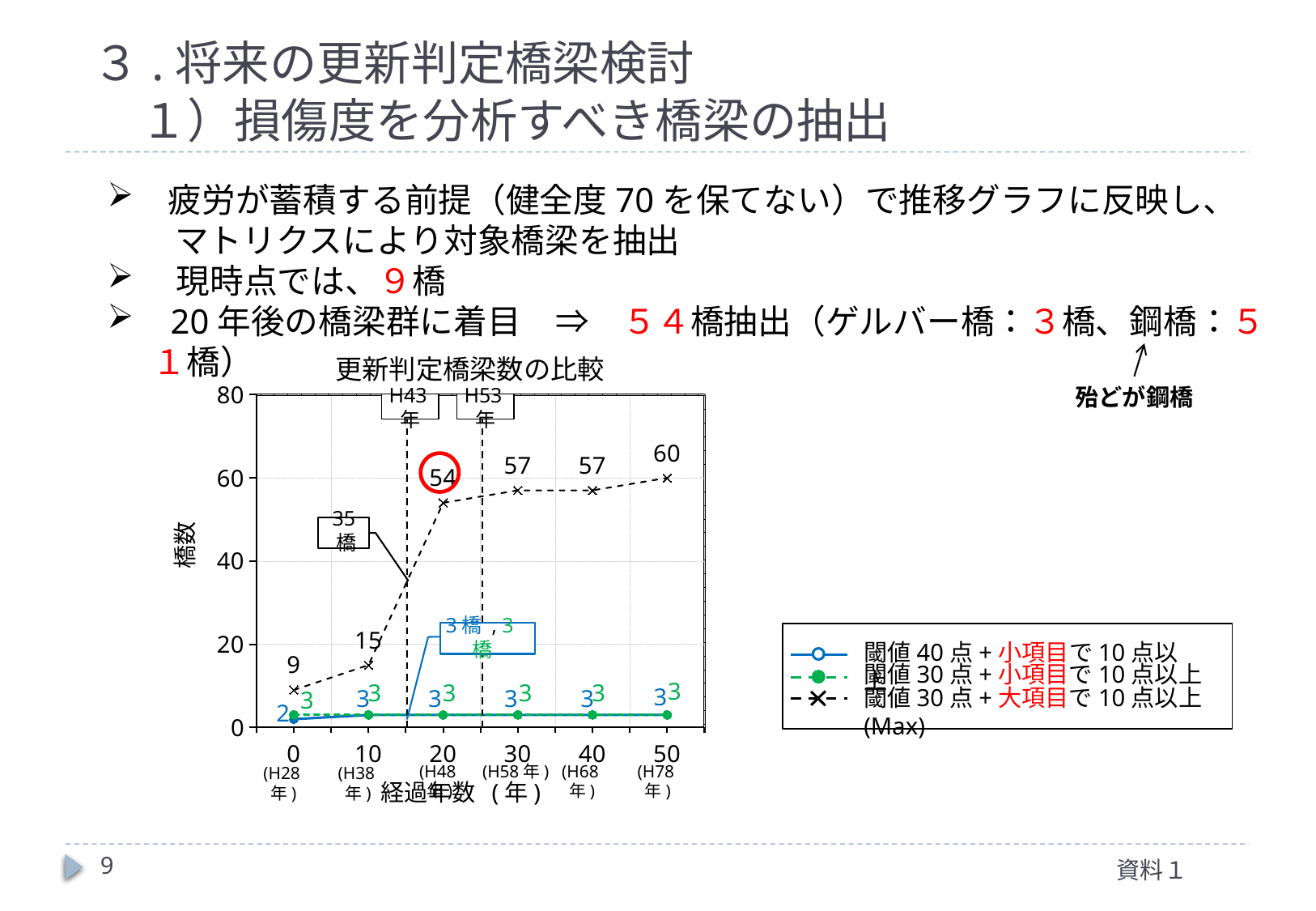
What is the value of the 閾値30点+大項目で10点以上(Max) series at 0 years (H28年)? 9 What is the title of the chart on the slide? 更新判定橋梁数の比較 What is the value of the 閾値30点+大項目で10点以上(Max) series at 50 years (H78年)? 60 How many data points are plotted along the x axis for each series? 6 What is the value of the 閾値30点+小項目で10点以上 series at 30 years (H58年)? 3 At which elapsed year is the 閾値30点+大項目で10点以上(Max) series lowest? 0 At which elapsed year is the 閾値30点+大項目で10点以上(Max) series highest? 50 Does the 閾値30点+大項目で10点以上(Max) series rise or fall as elapsed years increase? rise What is the difference between the 閾値30点+大項目で10点以上(Max) values at 20 years and 10 years? 39 What is the value of the 閾値30点+大項目で10点以上(Max) series at 20 years (H48年)? 54 How many series does the chart's legend list? 3 What kind of chart is shown on the slide? line chart